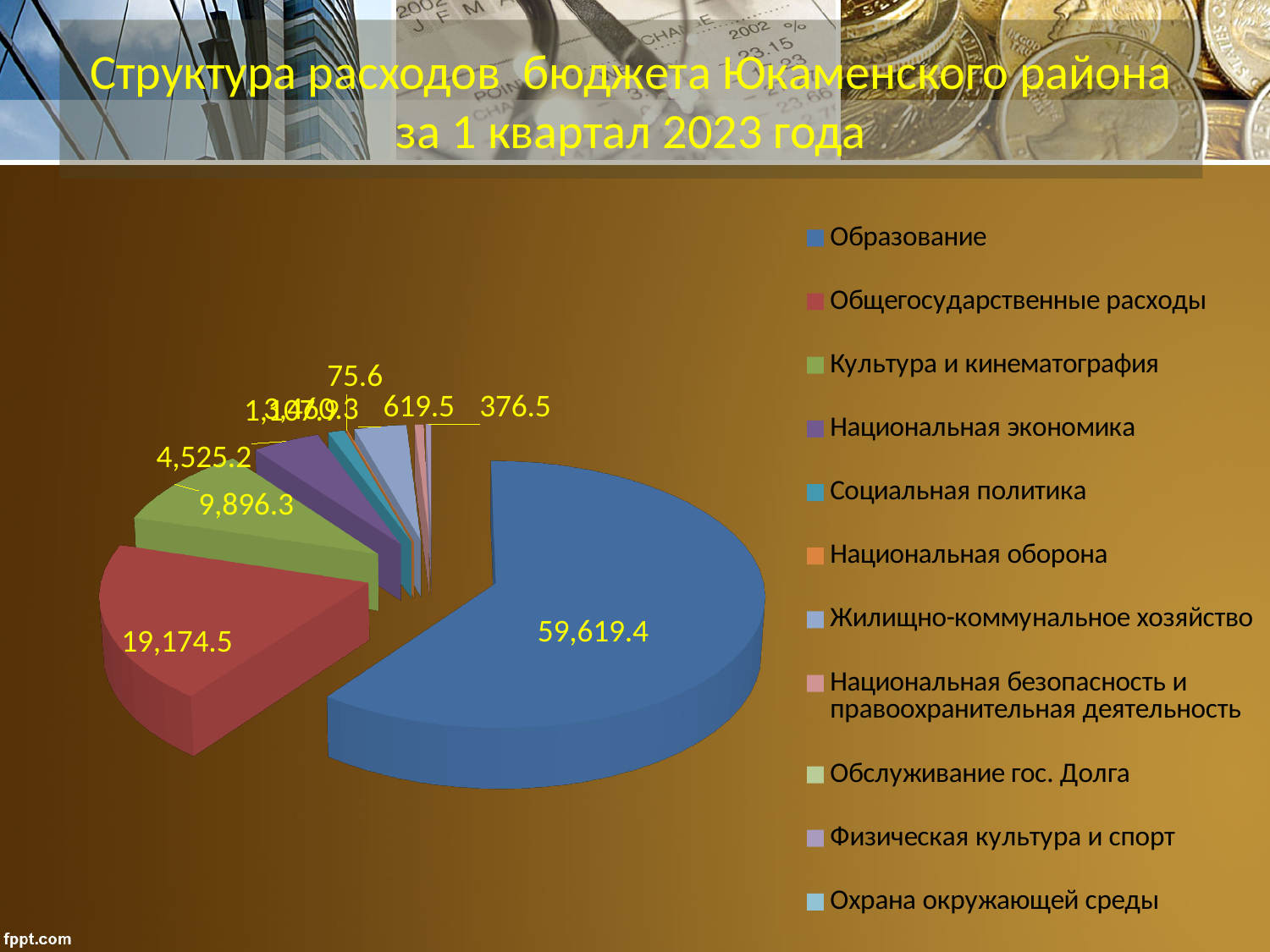
What is the value shown for Национальная экономика? 4,525.2 What is the difference between the values for Образование and Общегосударственные расходы? 40,444.9 What colour is the slice for Образование? blue What is the title of the slide? Структура расходов бюджета Юкаменского района за 1 квартал 2023 года How many categories does the legend of the pie chart list? 11 What is the difference between the values for Общегосударственные расходы and Культура и кинематография? 9,278.2 Which is larger, the value for Культура и кинематография or the value for Национальная экономика? Культура и кинематография Which category has the largest slice of the pie? Образование What is the value shown for Культура и кинематография? 9,896.3 What is the value shown for Образование? 59,619.4 What is the value shown for Общегосударственные расходы? 19,174.5 What kind of chart is shown on the slide? pie chart